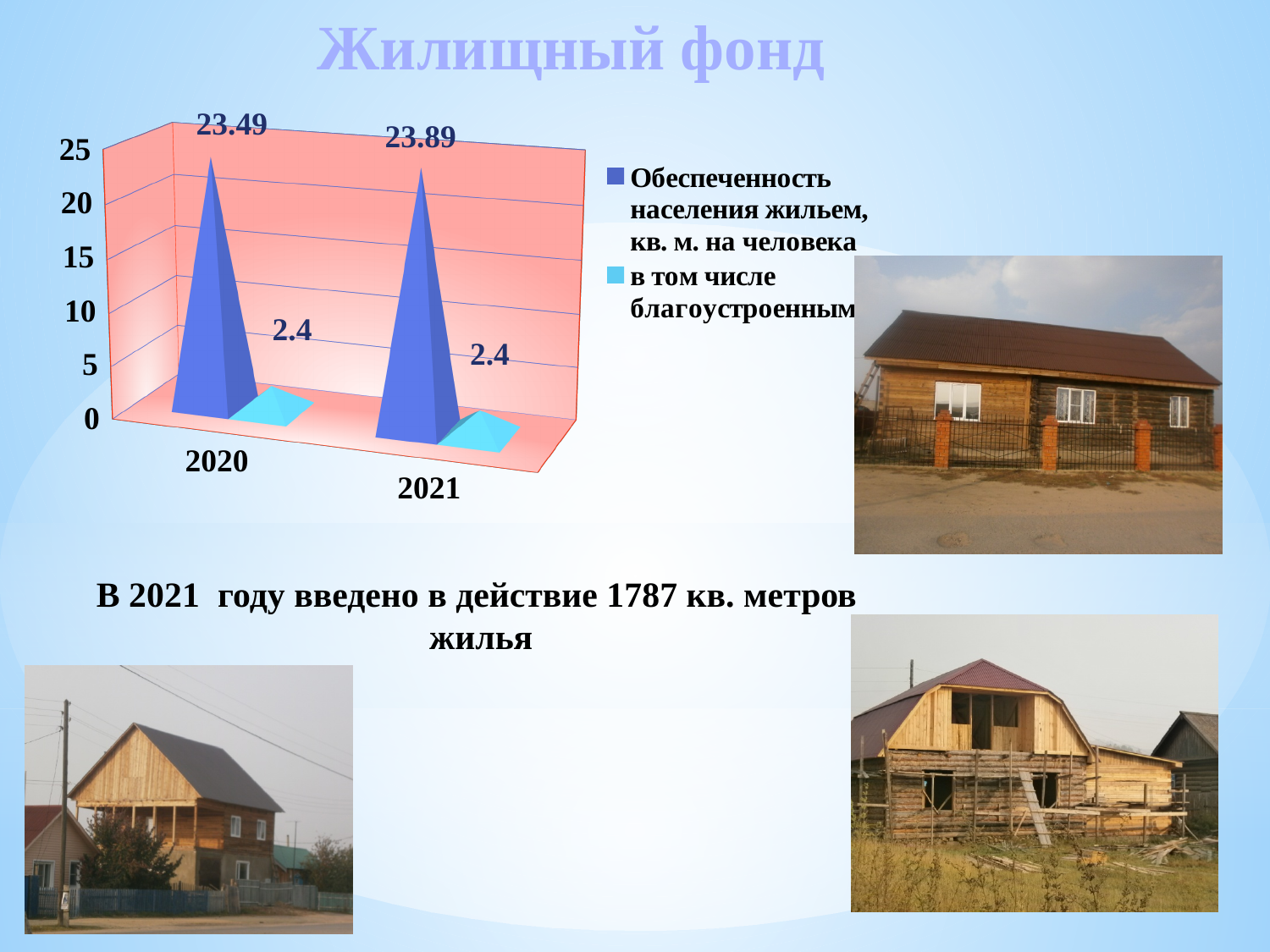
What is the value of 'Обеспеченность населения жильем, кв. м. на человека' for 2020? 23.49 Does 'Обеспеченность населения жильем' rise or fall from 2020 to 2021? rise How many years (categories) are shown on the x axis of the chart? 2 What is the value of 'в том числе благоустроенным' for 2020? 2.4 Which is larger in 2020: 'Обеспеченность населения жильем' or 'в том числе благоустроенным'? Обеспеченность населения жильем What is the difference between the 'Обеспеченность населения жильем' values for 2021 and 2020? 0.4 What is the value of 'Обеспеченность населения жильем, кв. м. на человека' for 2021? 23.89 Is the value of 'Обеспеченность населения жильем' for 2021 greater or less than 20? greater How many series does the chart legend list? 2 What is the value of 'в том числе благоустроенным' for 2021? 2.4 What is the maximum value shown on the chart's vertical axis? 25 In which year is 'Обеспеченность населения жильем, кв. м. на человека' higher? 2021